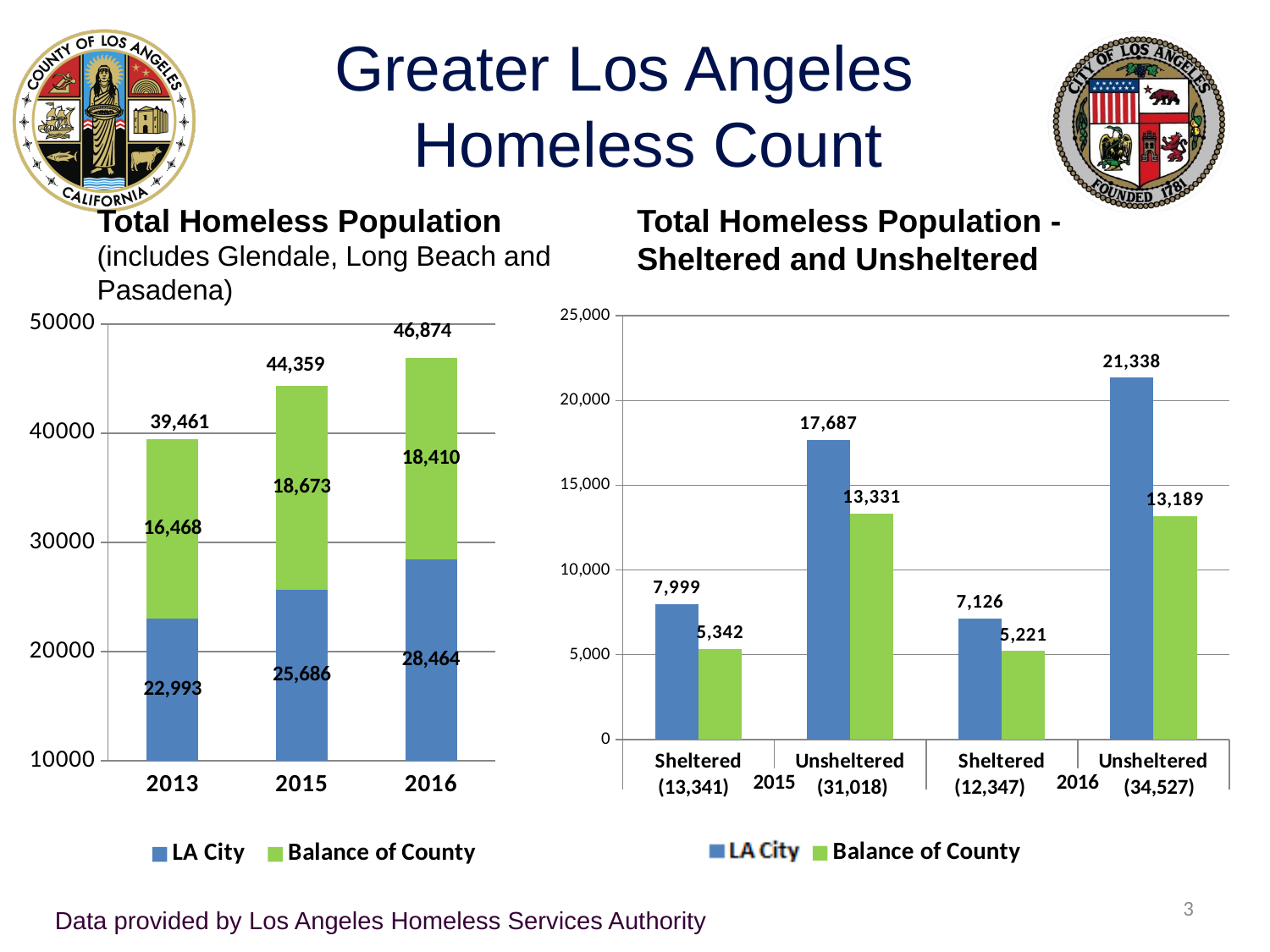
How many series does the legend of the 'Total Homeless Population - Sheltered and Unsheltered' chart list? 2 In the 'Total Homeless Population' chart, which year has the highest total homeless population? 2016 In the 'Total Homeless Population' chart, what is the LA City value for 2013? 22,993 In the 'Total Homeless Population' chart, what is the Balance of County value for 2015? 18,673 In the 'Total Homeless Population' chart, what is the difference between the LA City values for 2016 and 2015? 2,778 In the 'Total Homeless Population - Sheltered and Unsheltered' chart, what is the Balance of County value for Sheltered in 2015? 5,342 In the 'Total Homeless Population - Sheltered and Unsheltered' chart, what is the LA City value for Unsheltered in 2016? 21,338 In the 'Total Homeless Population' chart, does the LA City value rise or fall from 2013 to 2016? rise In the 'Total Homeless Population - Sheltered and Unsheltered' chart, what is the difference between the LA City Unsheltered values for 2016 and 2015? 3,651 In the 'Total Homeless Population' chart, what is the total of the stacked bar for 2016? 46,874 In the 'Total Homeless Population' chart, how many years are shown on the x axis? 3 In the 'Total Homeless Population - Sheltered and Unsheltered' chart, which is larger: the LA City Sheltered value in 2015 or in 2016? 2015